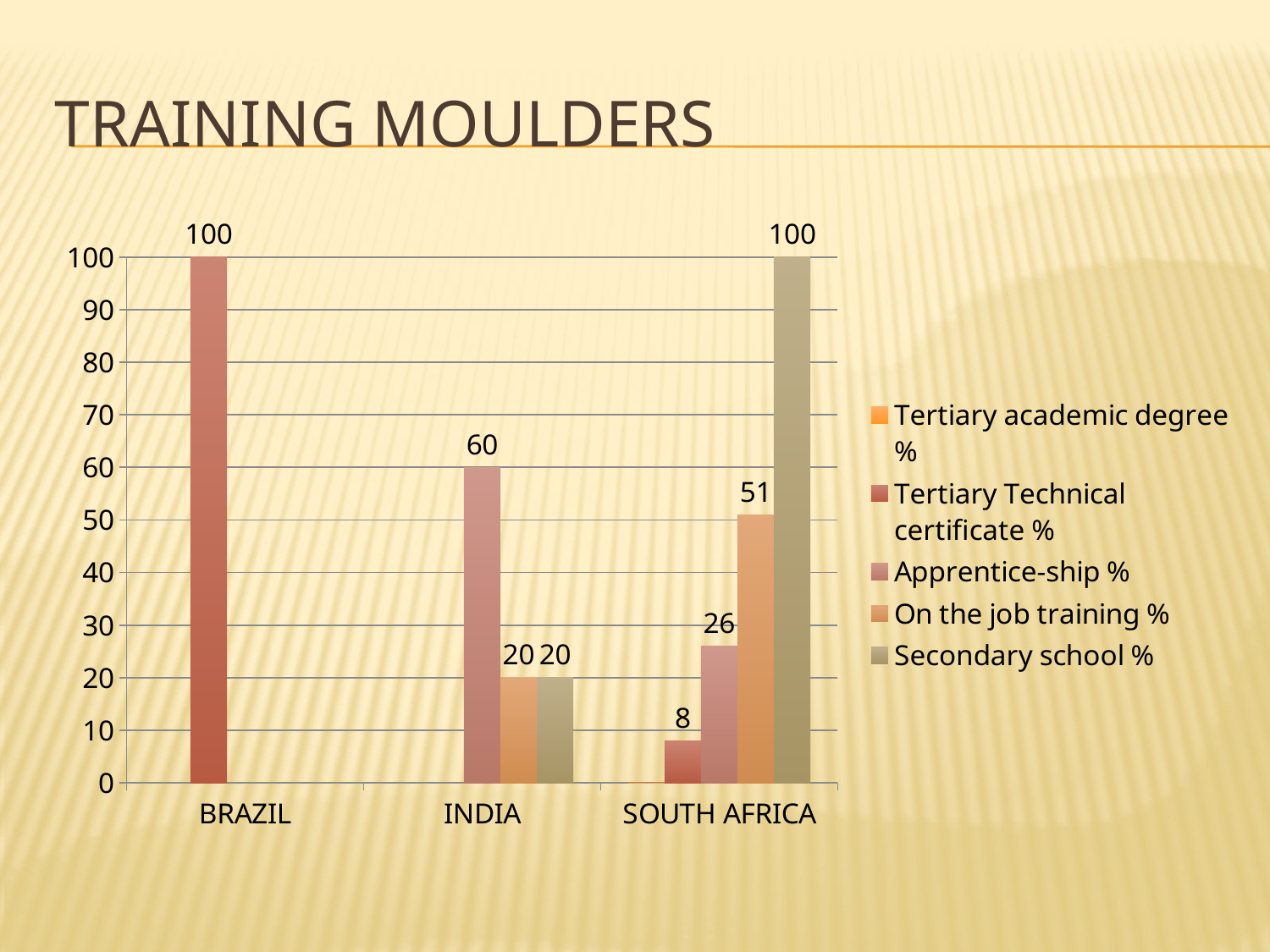
What is the Tertiary Technical certificate % value for BRAZIL? 100 What is the Secondary school % value for SOUTH AFRICA? 100 How many countries are shown on the x axis? 3 What is the difference between the Apprentice-ship % values for INDIA and SOUTH AFRICA? 34 Which series has the highest value for INDIA? Apprentice-ship % Which is larger: the On the job training % value for INDIA or for SOUTH AFRICA? SOUTH AFRICA What kind of chart is shown on the slide? bar chart What is the On the job training % value for SOUTH AFRICA? 51 What is the title of the chart? TRAINING MOULDERS How many series does the legend list? 5 What is the Apprentice-ship % value for INDIA? 60